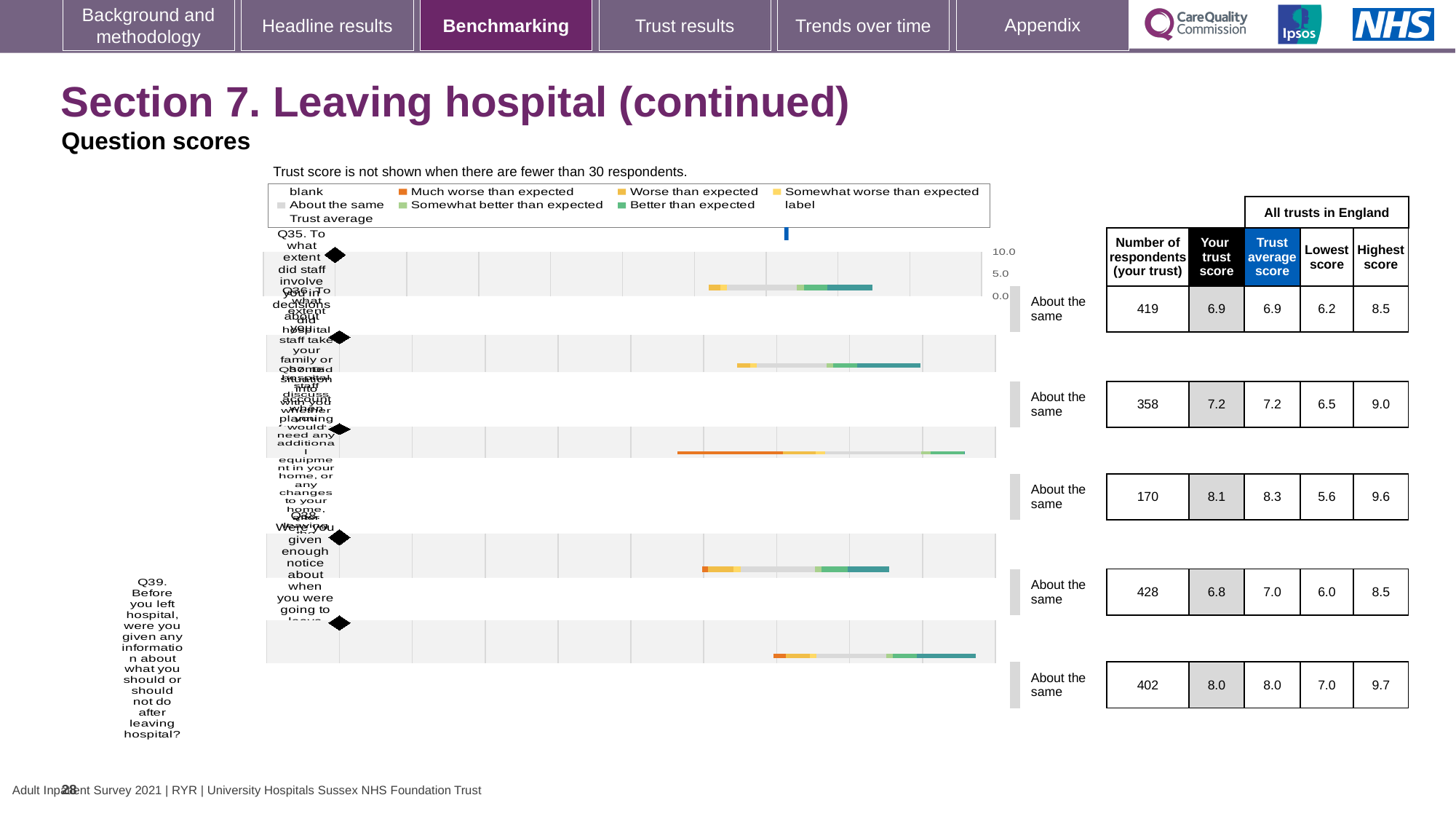
What kind of chart is used to show the question scores? Bar chart For the third question row (Q37), is the trust score or the trust average score larger? Trust average score (8.3) What colour does the legend use for 'Much worse than expected'? Orange What benchmark category is shown for every question row on this slide? About the same How many question rows are shown in the chart? 5 Which question row has the most respondents? Q38 (fourth row), 428 What is the difference between the highest score and the lowest score for Q35, the first question row? 2.3 Which question row has the fewest respondents? Q37 (third row), 170 What is the trust score for Q39, the last question row about information on what you should or should not do after leaving hospital? 8.0 What is the number of respondents (your trust) for Q35, the first question row? 419 What is the highest score across all trusts in England for Q39, the last question row? 9.7 What is the lowest score across all trusts in England for Q35, the first question row? 6.2